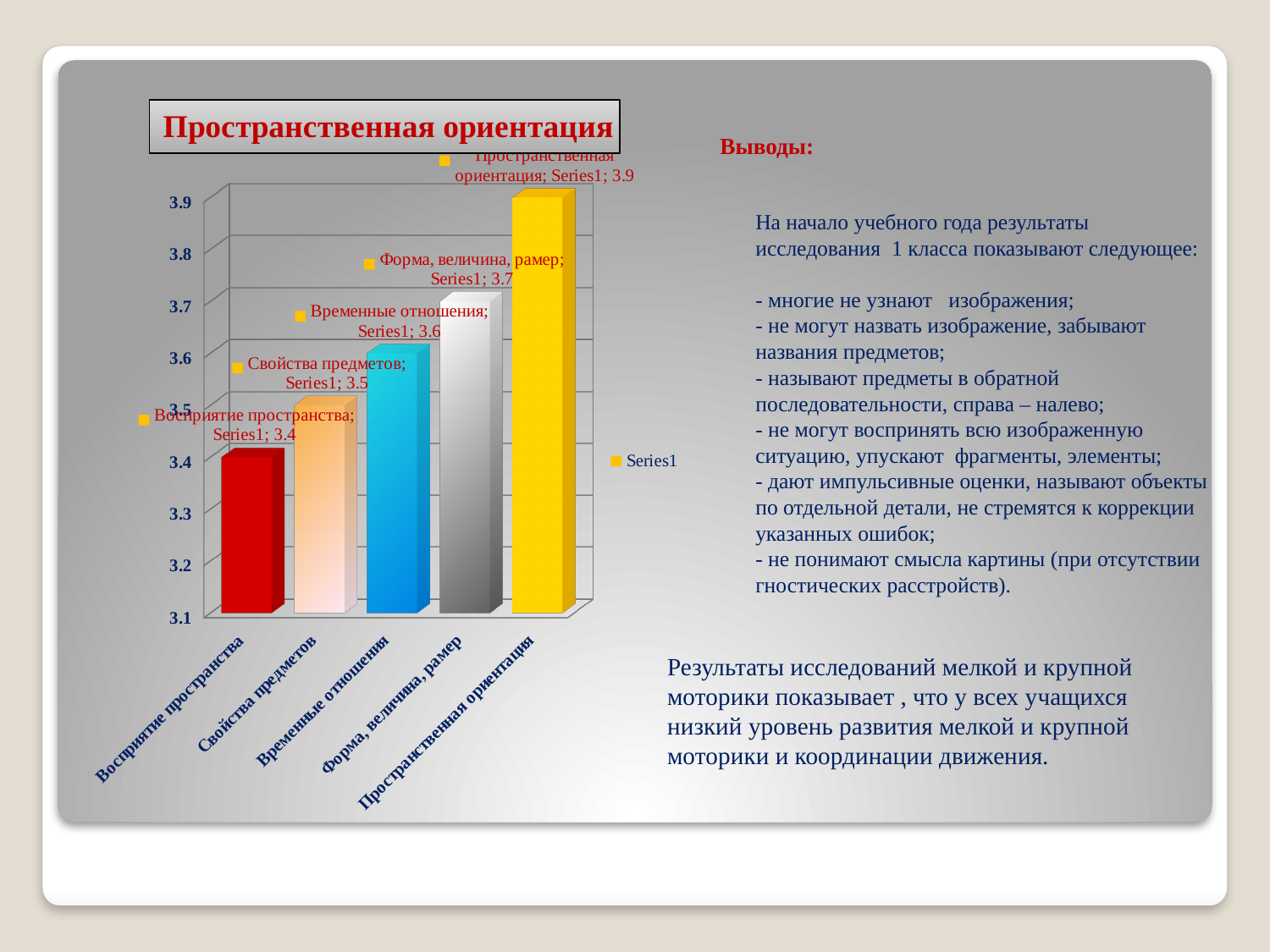
Which category has the highest value? Пространственная ориентация What is the value for Временные отношения? 3.6 How many series does the legend list? 1 What is the value for Свойства предметов? 3.5 How many categories are shown on the chart? 5 What is the value for Восприятие пространства? 3.4 What kind of chart is shown on the slide? Bar chart Do the values rise or fall from left to right along the x axis? Rise What is the difference between the values for Пространственная ориентация and Восприятие пространства? 0.5 Which is larger, the value for Форма, величина, рамер or the value for Свойства предметов? Форма, величина, рамер What is the value for Пространственная ориентация? 3.9 Which category has the lowest value? Восприятие пространства